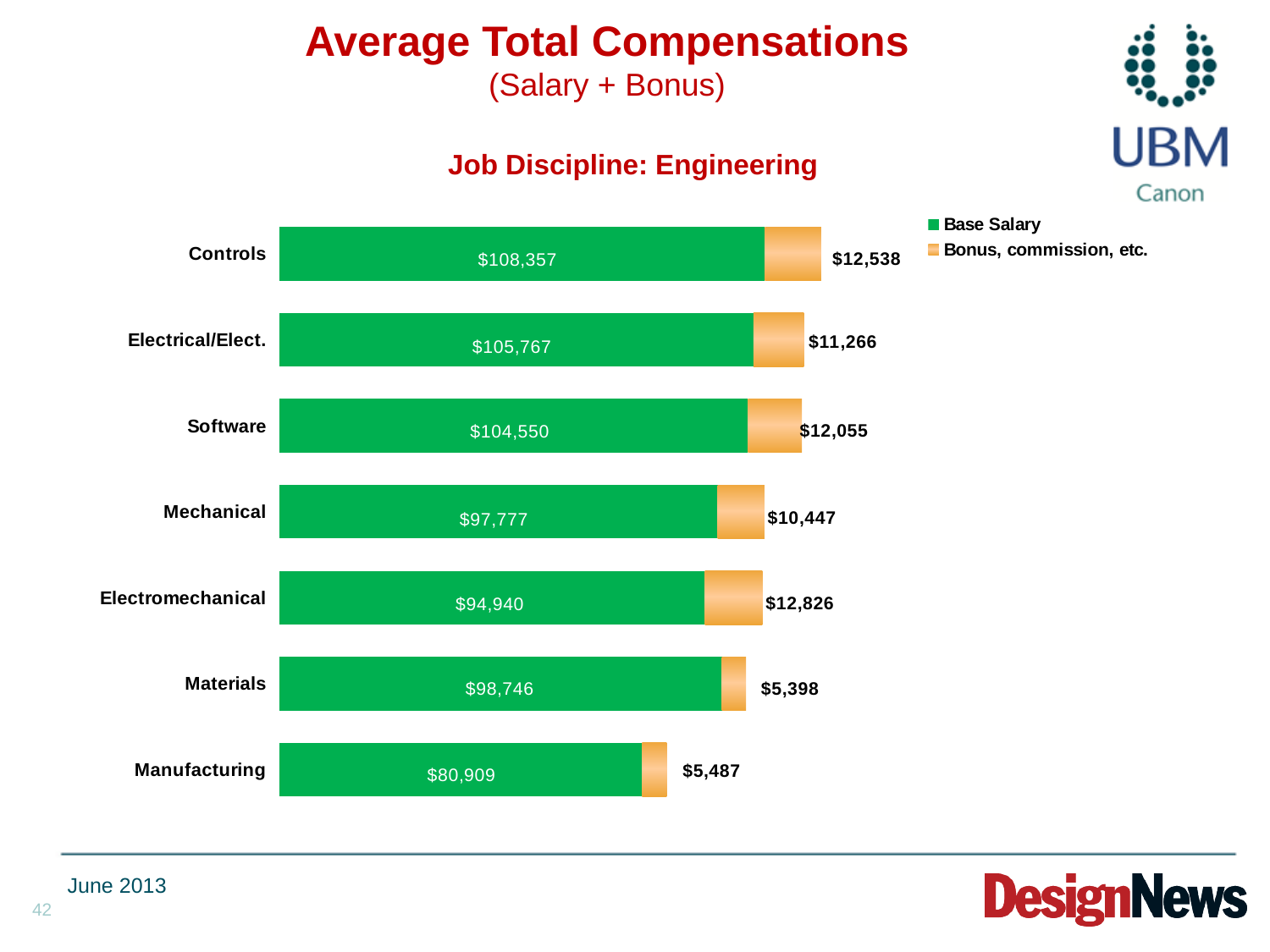
Which job discipline has the lowest base salary? Manufacturing What is the base salary for Software engineering? $104,550 What is the total compensation (base salary plus bonus) for Controls? $120,895 How many job disciplines are shown in the chart? 7 Which is larger, the base salary for Materials or the base salary for Mechanical? Materials What is the bonus, commission, etc. value for Mechanical engineering? $10,447 What is the total compensation (base salary plus bonus) for Manufacturing? $86,396 What is the difference between the base salary for Controls and the base salary for Manufacturing? $27,448 How many series does the legend list? 2 Which job discipline has the highest base salary? Controls What type of chart is shown on the slide? Stacked bar chart Which job discipline has the highest bonus, commission, etc. value? Electromechanical